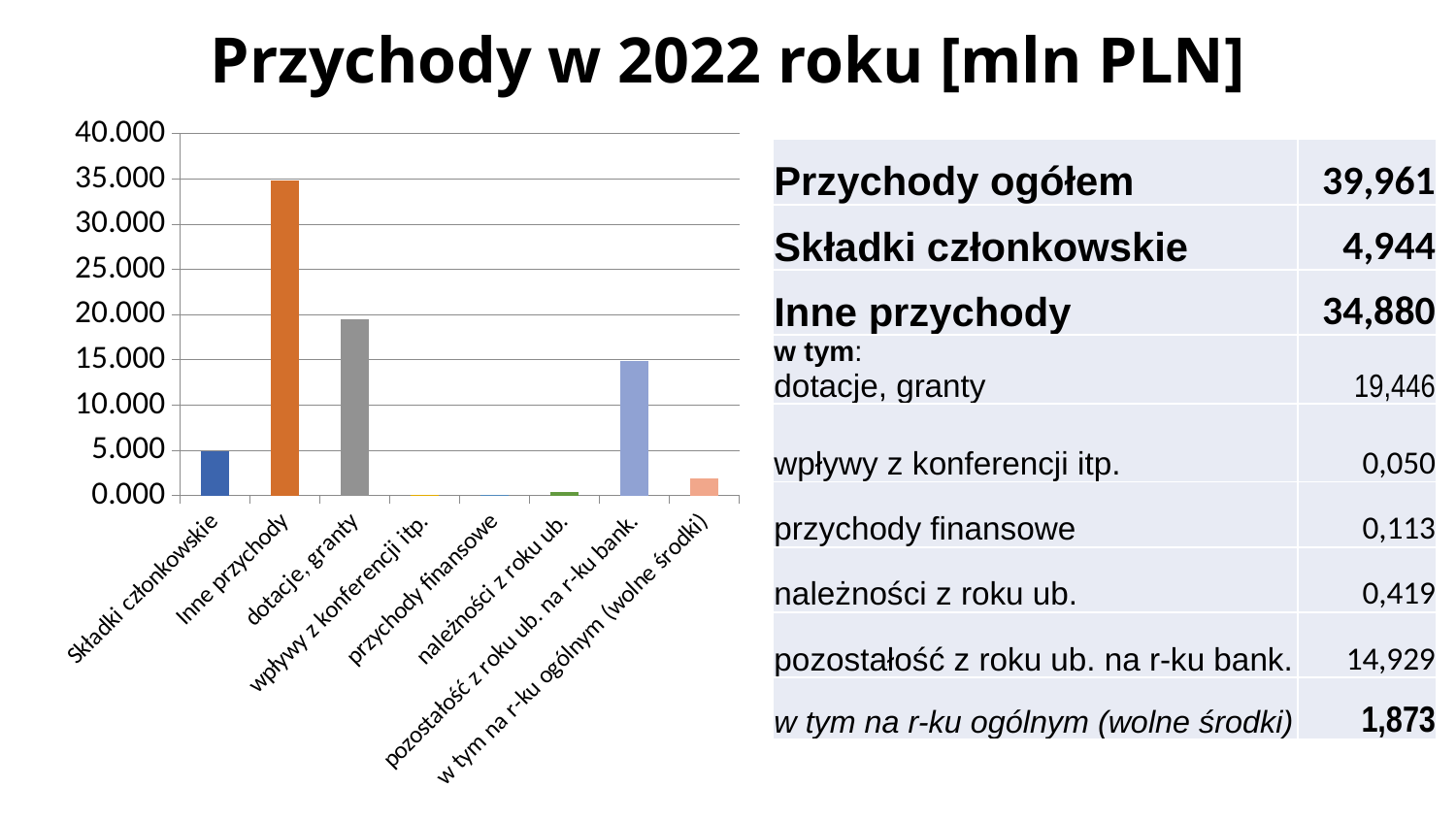
Which is larger, dotacje, granty or pozostałość z roku ub. na r-ku bank.? dotacje, granty Is the value for w tym na r-ku ogólnym (wolne środki) greater or less than 5.000? less How many categories are plotted on the x axis of the chart? 8 What is the value for Składki członkowskie? 4,944 Which category has the highest bar in the chart? Inne przychody What is the difference between Inne przychody and dotacje, granty? 15,434 Is the value for Inne przychody greater or less than 30.000? greater What is the value for Inne przychody? 34,880 What kind of chart is shown on the slide? bar chart What is the value for pozostałość z roku ub. na r-ku bank.? 14,929 What is the value for dotacje, granty? 19,446 What is the title of the chart? Przychody w 2022 roku [mln PLN]